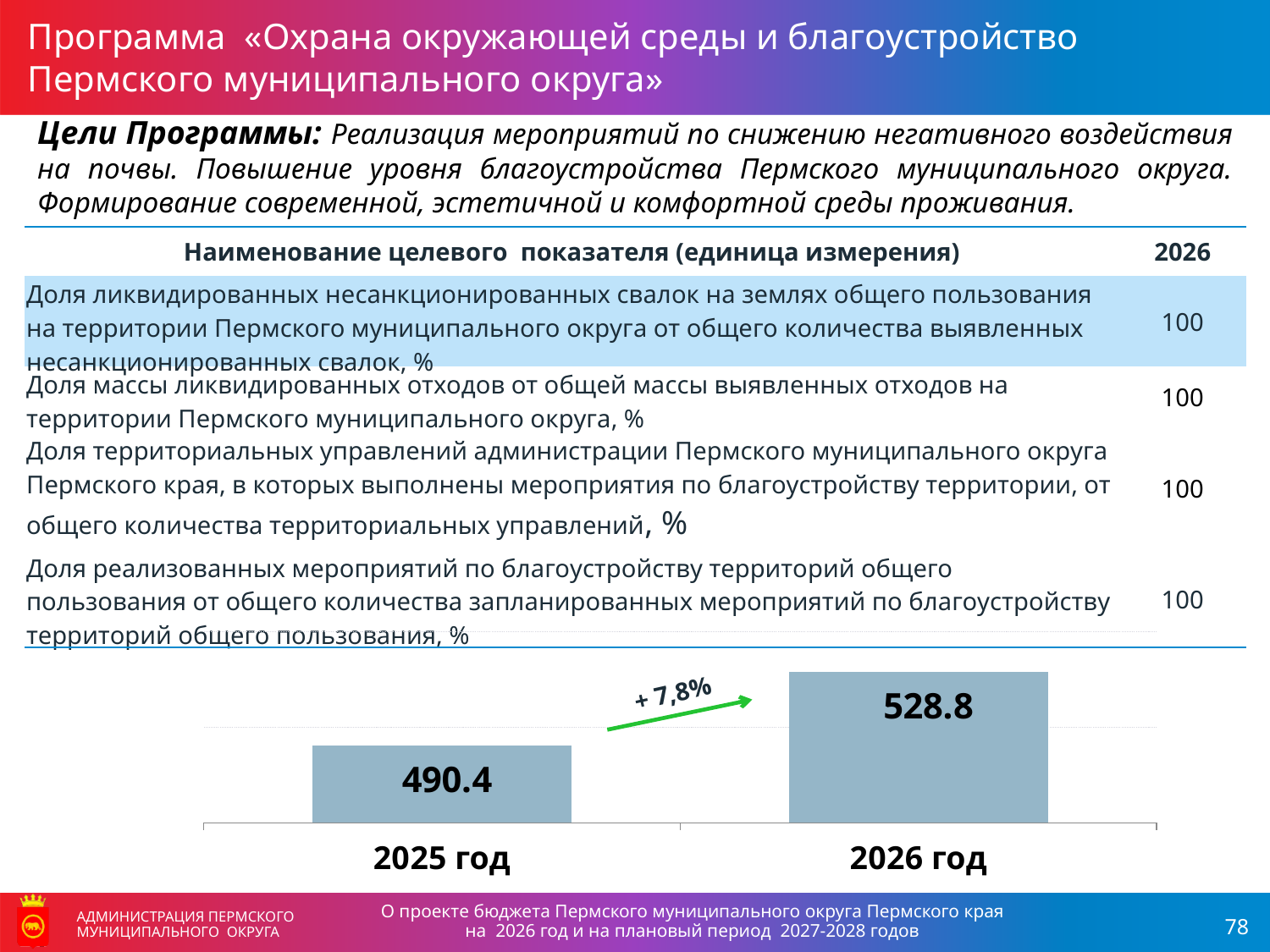
What is the value for 2026 год in the bar chart? 528.8 What is the difference between the values for 2026 год and 2025 год in the bar chart? 38.4 What kind of chart is shown at the bottom of the slide? bar chart What percentage change is annotated on the arrow between the two bars? + 7,8% Which year has the lower value in the bar chart? 2025 год Which year has the higher value in the bar chart? 2026 год How many bars are shown in the chart? 2 Do the values rise or fall from 2025 год to 2026 год? rise Is the value for 2026 год larger or smaller than the value for 2025 год? larger What are the category labels on the x axis of the bar chart? 2025 год, 2026 год What is the value for 2025 год in the bar chart? 490.4